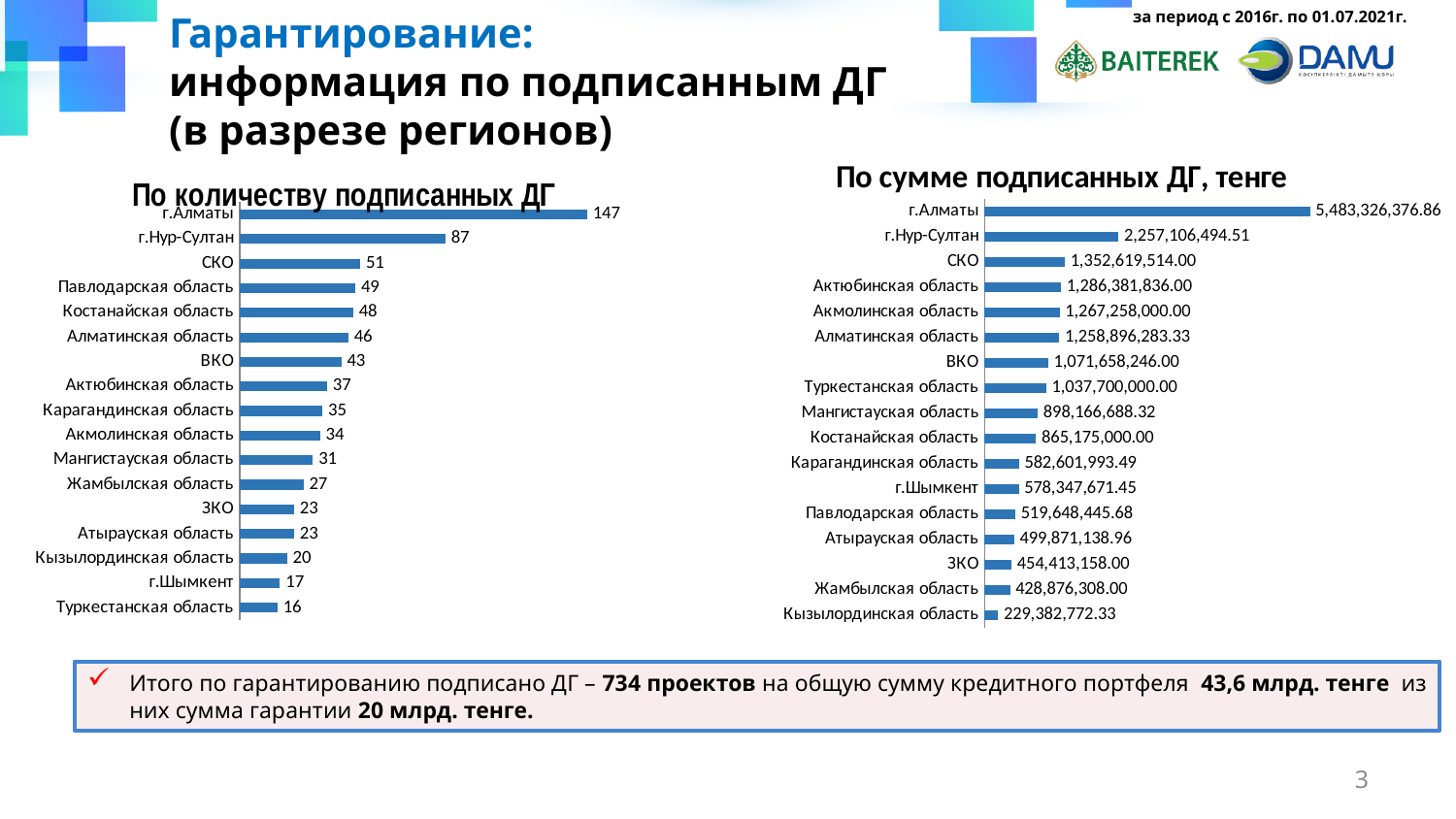
In the chart 'По сумме подписанных ДГ, тенге', what is the value for Кызылординская область? 229,382,772.33 In the chart 'По сумме подписанных ДГ, тенге', which region has the highest value? г.Алматы In the chart 'По количеству подписанных ДГ', which is larger: Павлодарская область or ВКО? Павлодарская область In the chart 'По количеству подписанных ДГ', what is the value for г.Алматы? 147 In the chart 'По сумме подписанных ДГ, тенге', what is the difference between г.Алматы and г.Нур-Султан? 3,226,219,882.35 What type of chart is 'По сумме подписанных ДГ, тенге'? Bar chart In the chart 'По количеству подписанных ДГ', what is the value for Костанайская область? 48 In the chart 'По сумме подписанных ДГ, тенге', which is larger: Мангистауская область or Костанайская область? Мангистауская область In the chart 'По количеству подписанных ДГ', which region has the lowest value? Туркестанская область In the chart 'По сумме подписанных ДГ, тенге', what is the value for СКО? 1,352,619,514.00 In the chart 'По количеству подписанных ДГ', what is the difference between г.Алматы and г.Нур-Султан? 60 In the chart 'По количеству подписанных ДГ', how many regions are shown? 17